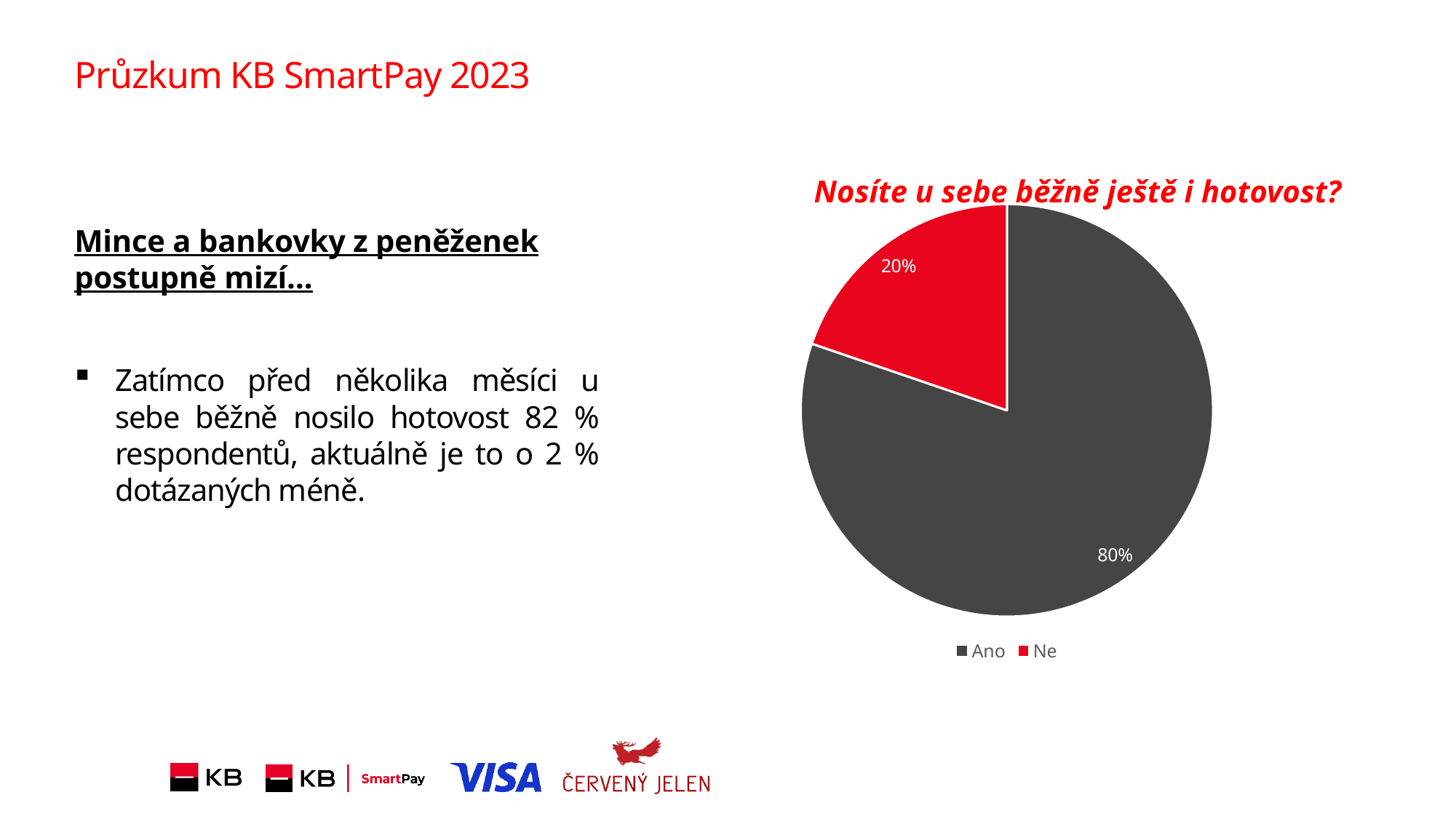
Which slice is larger, "Ano" or "Ne"? Ano Which category has the smallest slice of the pie? Ne What kind of chart is shown on the slide? pie chart Which category has the largest slice of the pie? Ano What colour is the "Ne" slice in the pie chart? red How many entries does the legend list? 2 How many categories does the pie chart show? 2 What is the title of the pie chart? Nosíte u sebe běžně ještě i hotovost? What is the difference in percentage points between the "Ano" and "Ne" slices? 60% What share of the pie does the "Ano" slice represent? 80% What share of the pie does the "Ne" slice represent? 20%